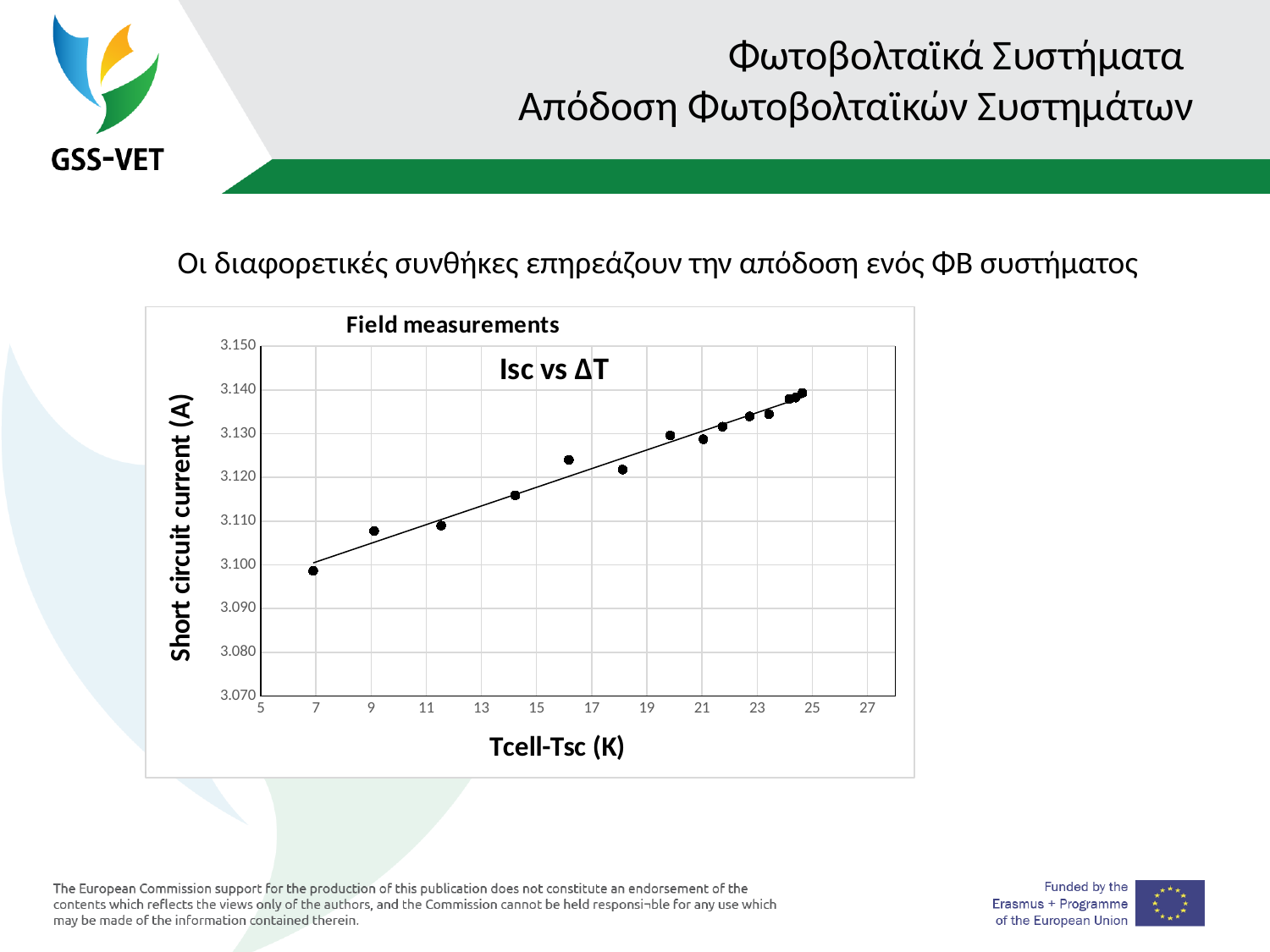
At which end of the Tcell-Tsc axis is the lowest short circuit current found? the left end (lowest Tcell-Tsc) Is the highest plotted short circuit current greater or less than 3.130? greater What is the title of the chart? Isc vs ΔT Is the lowest plotted short circuit current greater or less than 3.090? greater Is the short circuit current at Tcell-Tsc of about 18 K greater or less than 3.130? less Does the short circuit current rise or fall as Tcell-Tsc increases? rise Which has the larger short circuit current: the point at about 9 K or the point at about 20 K? the point at about 20 K Which has the larger short circuit current: the point at about 7 K or the point at about 24 K? the point at about 24 K What is the label of the x axis? Tcell-Tsc (K) What kind of chart is shown on the slide? scatter chart